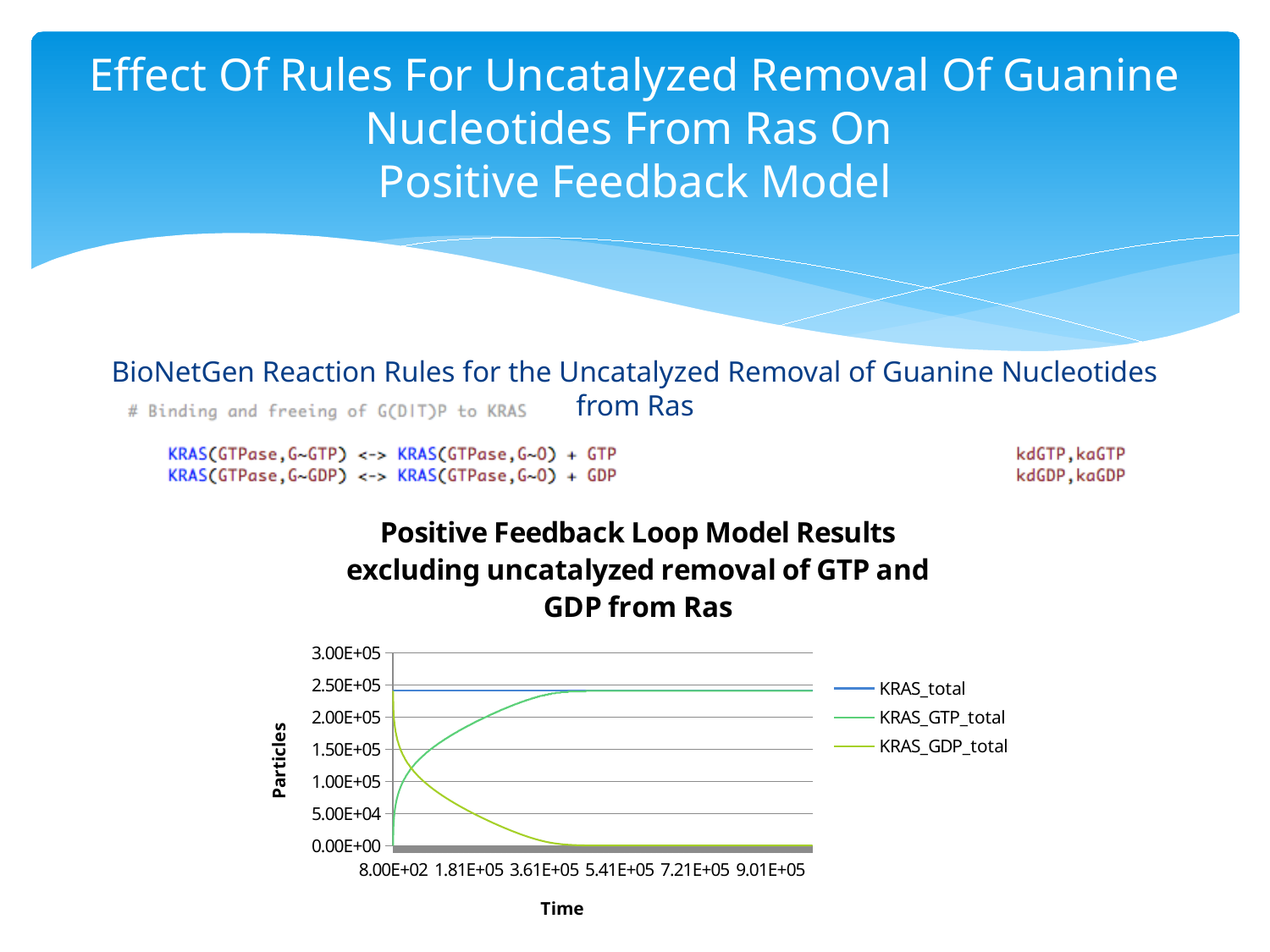
What kind of chart is shown on the slide? line chart At the right end of the x axis, is the value of KRAS_GDP_total greater or less than 5.00E+04? less At the right end of the x axis, is the value of KRAS_GTP_total greater or less than 2.00E+05? greater Does the KRAS_GDP_total series rise or fall along the x axis? fall Does the KRAS_GTP_total series rise or fall along the x axis? rise Is the value of KRAS_total greater or less than 2.00E+05? greater How many tick labels are shown on the Time axis? 6 At the right end of the x axis, which series is larger, KRAS_GTP_total or KRAS_GDP_total? KRAS_GTP_total At the left end of the x axis, which series is larger, KRAS_GTP_total or KRAS_GDP_total? KRAS_GDP_total What is the label of the vertical axis of the chart? Particles How many series does the chart legend list? 3 What is the title of the chart? Positive Feedback Loop Model Results excluding uncatalyzed removal of GTP and GDP from Ras